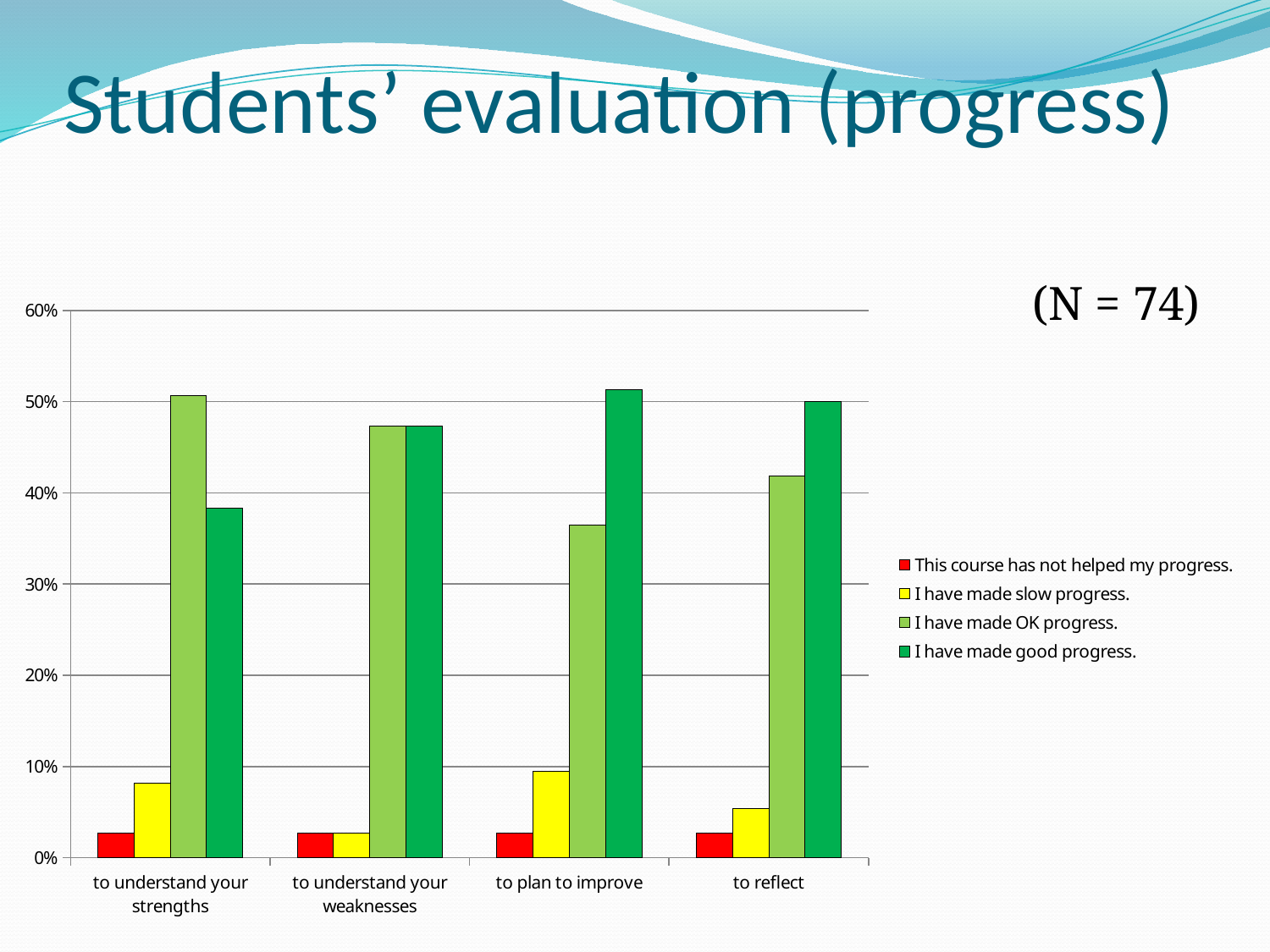
Is the value of "I have made OK progress." for "to plan to improve" greater or less than 40%? less How many categories are shown on the x axis of the chart? 4 For "to understand your strengths", which is larger: "I have made OK progress." or "I have made good progress."? I have made OK progress. How many series does the chart's legend list? 4 Which category has the lowest value for "I have made good progress."? to understand your strengths Which category has the highest value for "I have made slow progress."? to plan to improve Which legend entry is shown in red? This course has not helped my progress. Is the value of "I have made OK progress." for "to understand your strengths" greater or less than 40%? greater Is the value of "I have made good progress." for "to reflect" greater or less than 40%? greater For "to plan to improve", which is larger: "I have made OK progress." or "I have made good progress."? I have made good progress. What kind of chart is shown on the slide? bar chart